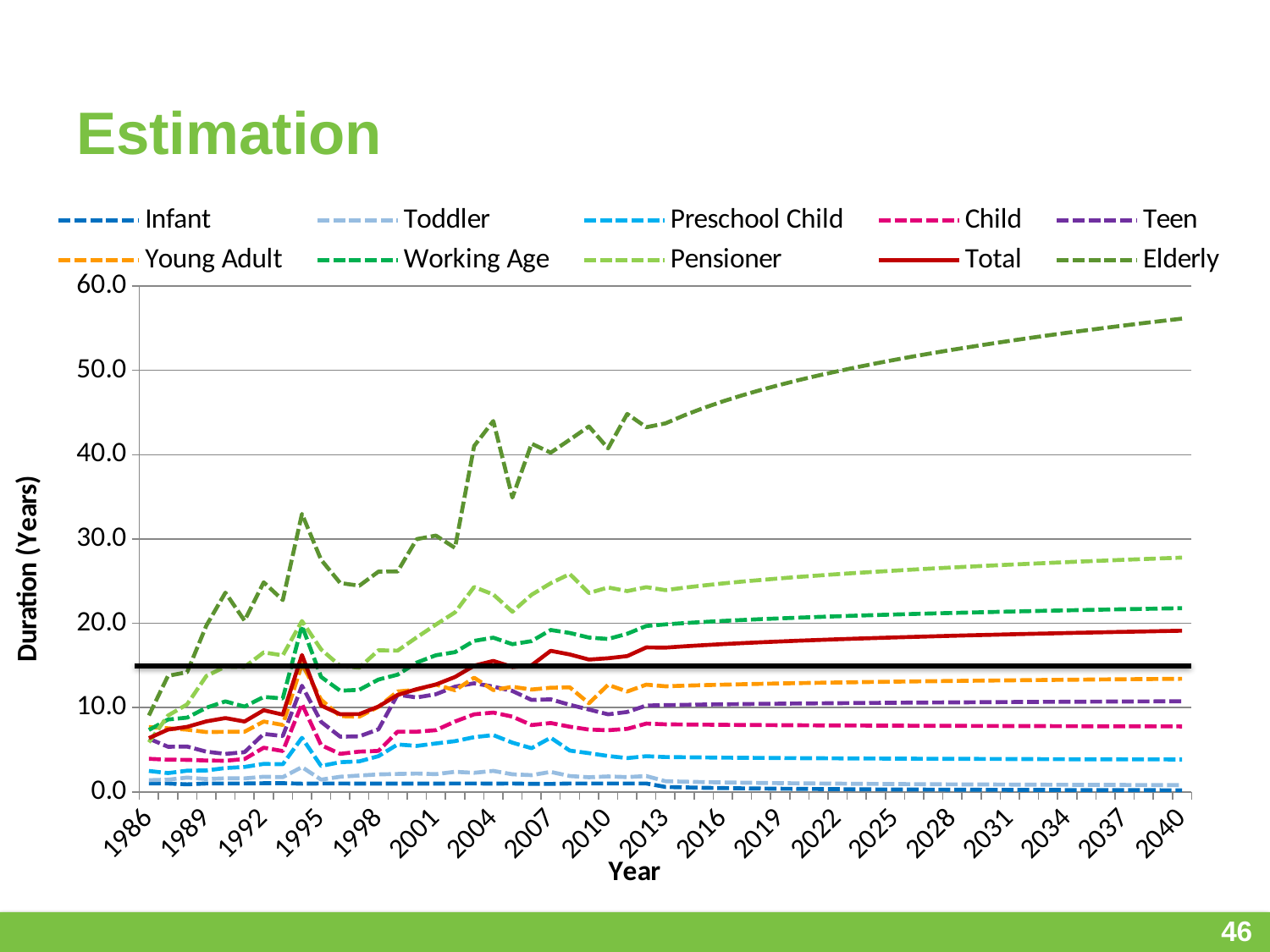
Does the Elderly series rise or fall from 2013 to 2040? rise Is the value for Preschool Child in 2040 greater or less than 10? less Which series has the highest values across the chart? Elderly How many series does the legend list? 10 Which is larger in 2040, Working Age or Total? Working Age What kind of chart is shown on the slide? line chart Is the value for Pensioner in 2040 greater or less than 30? less What is the label of the vertical axis? Duration (Years) Which series has the lowest values across the chart? Infant Is the value for Working Age in 2040 greater or less than 20? greater